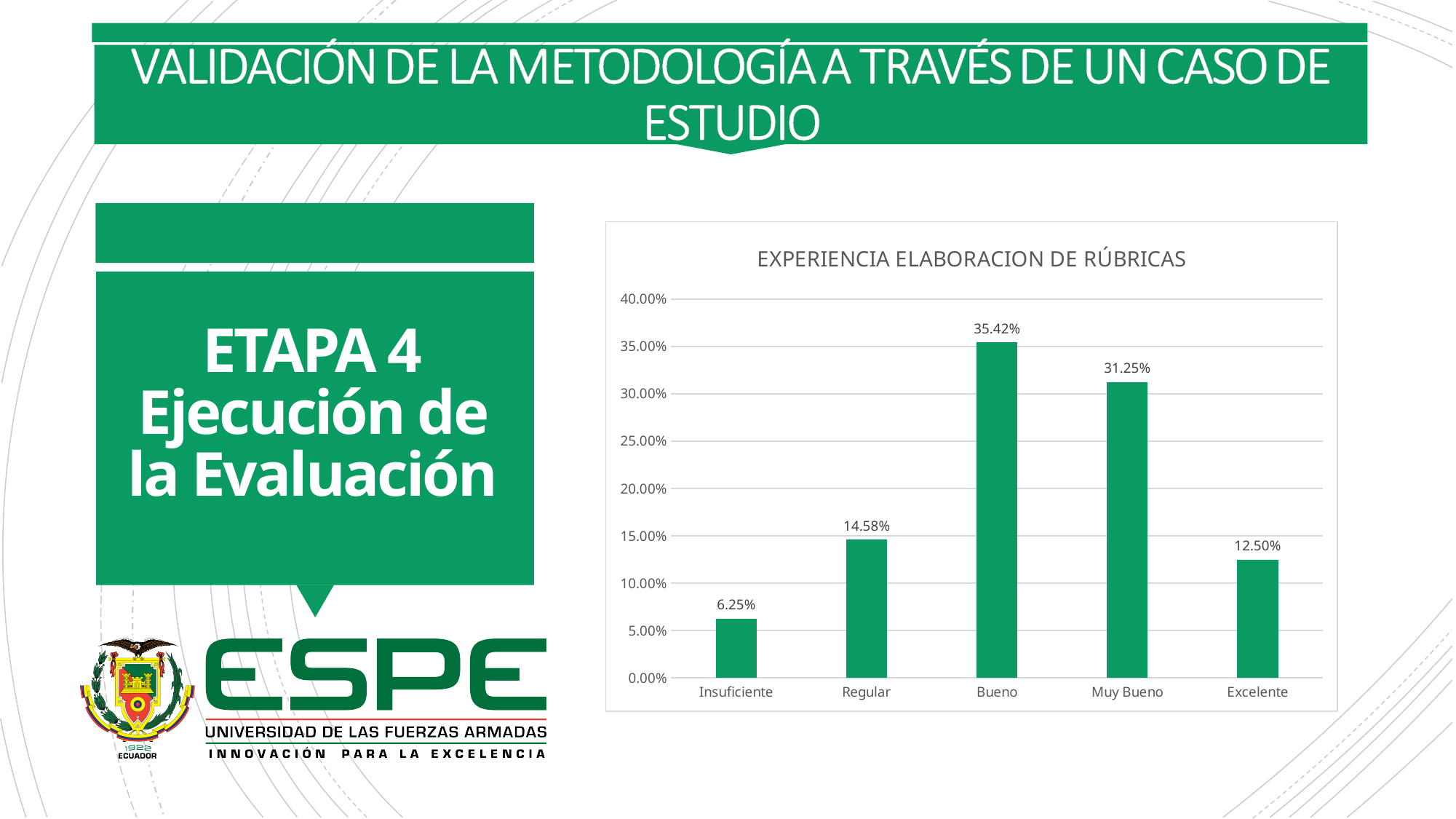
What kind of chart is shown? bar chart Which category has the highest value? Bueno What is the value for Bueno? 35.42% What is the value for Insuficiente? 6.25% What is the value for Excelente? 12.50% How many categories are shown on the x axis? 5 What is the difference between the values for Regular and Insuficiente? 8.33% Which is larger, the value for Regular or the value for Excelente? Regular Is the value for Muy Bueno greater or less than 30.00%? greater Which category has the lowest value? Insuficiente What is the title of the chart? EXPERIENCIA ELABORACION DE RÚBRICAS What is the difference between the values for Bueno and Muy Bueno? 4.17%